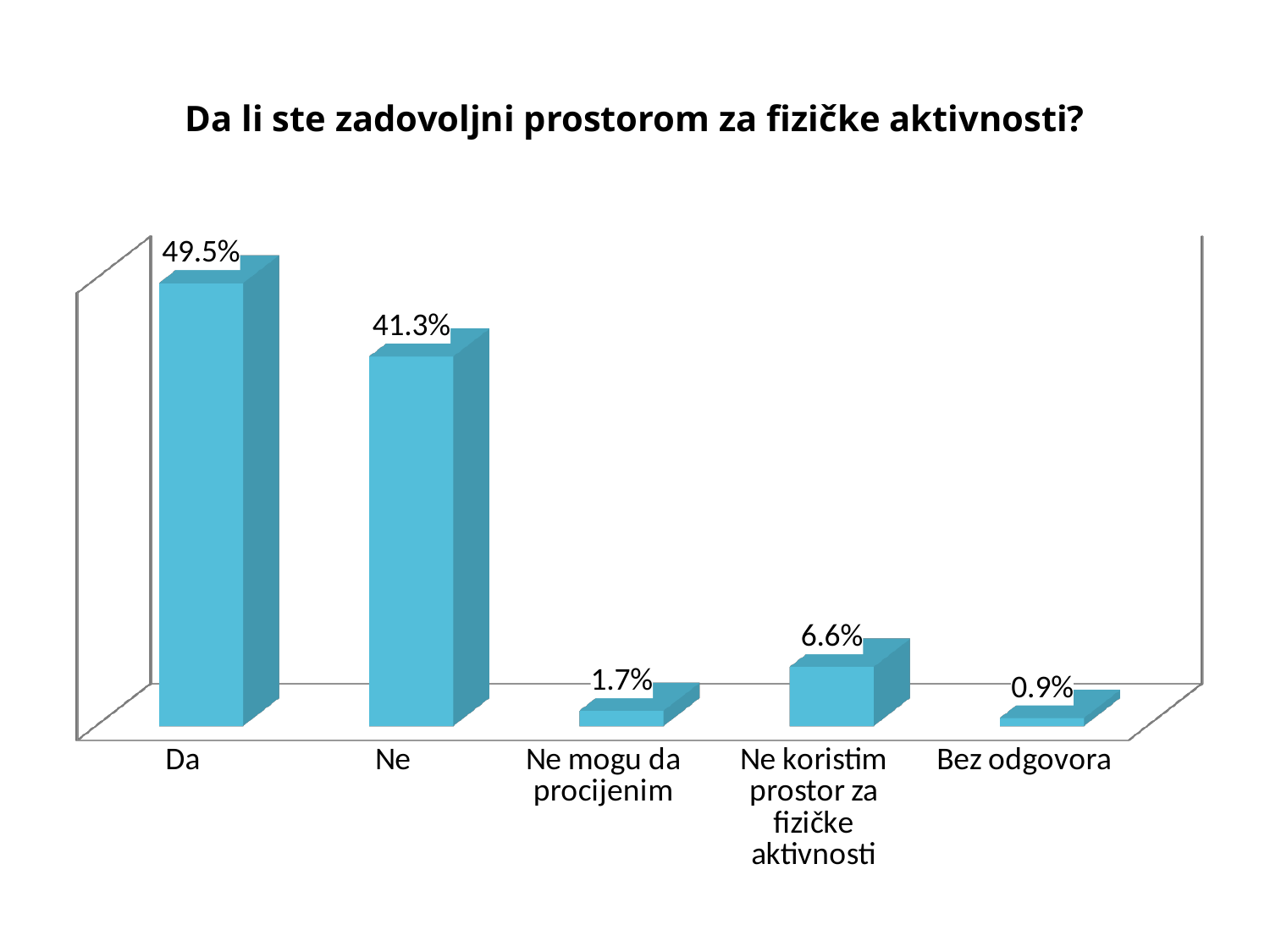
Which is larger, the value for "Ne koristim prostor za fizičke aktivnosti" or the value for "Ne mogu da procijenim"? Ne koristim prostor za fizičke aktivnosti What is the value for "Ne"? 41.3% What is the value for "Bez odgovora"? 0.9% Which category has the lowest value? Bez odgovora Which category has the highest value? Da What is the value for "Ne mogu da procijenim"? 1.7% What is the value for "Ne koristim prostor za fizičke aktivnosti"? 6.6% What is the title of the chart? Da li ste zadovoljni prostorom za fizičke aktivnosti? What is the difference between the values for "Da" and "Ne"? 8.2% How many categories are shown in the chart? 5 What kind of chart is shown on the slide? Bar chart What is the value for "Da"? 49.5%